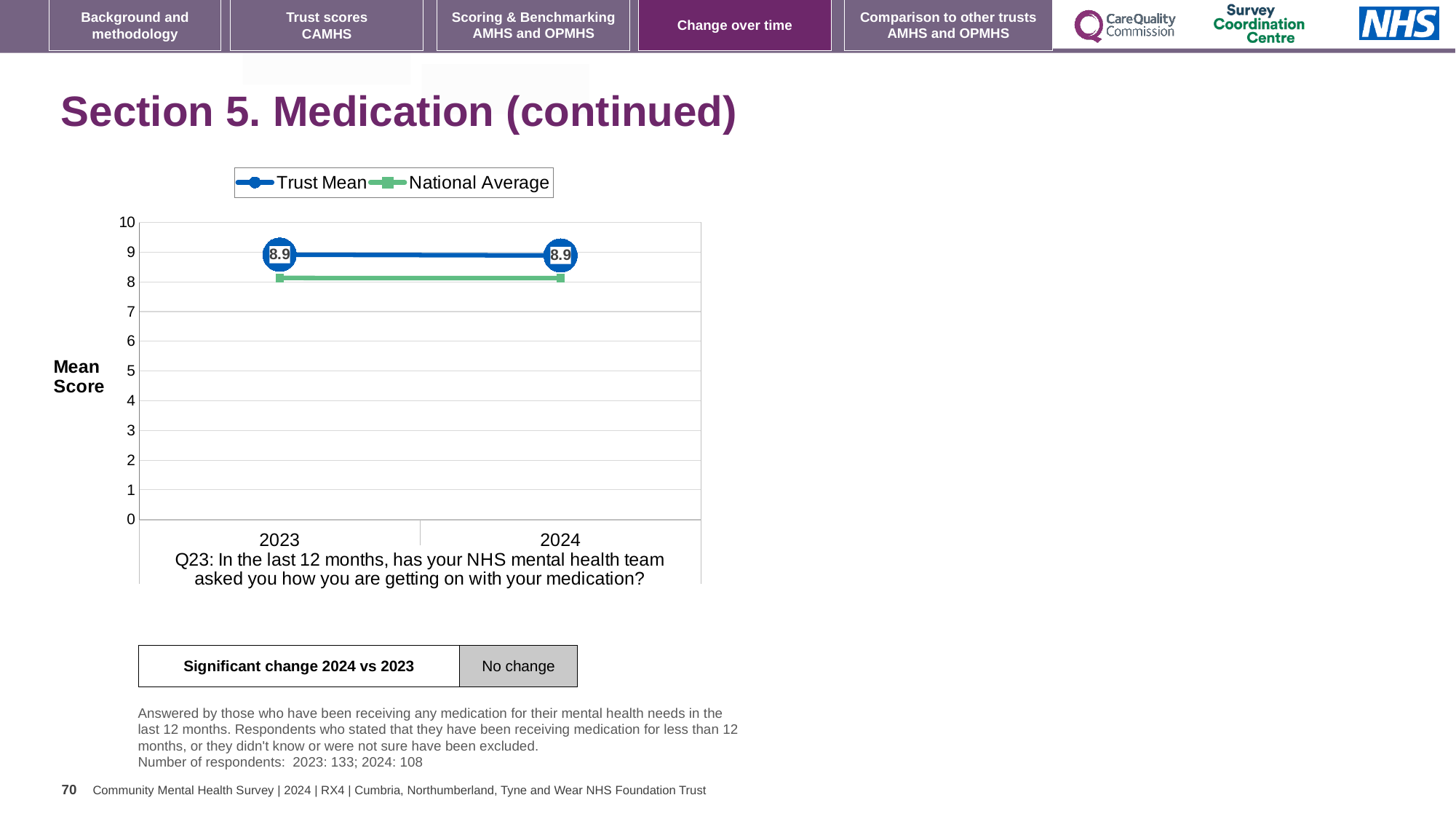
What is the Trust Mean value for 2023? 8.9 Is the National Average value for 2024 greater or less than 7? greater What are the two series named in the legend? Trust Mean and National Average What is the label on the y axis of the chart? Mean Score Is the National Average value for 2023 greater or less than 9? less What is the difference between the Trust Mean in 2024 and the Trust Mean in 2023? 0 What kind of chart is shown on the slide? Line chart How many series does the legend list? 2 In 2024, which is larger: the Trust Mean or the National Average? Trust Mean What is the Trust Mean value for 2024? 8.9 Does the Trust Mean rise, fall or stay the same from 2023 to 2024? Stays the same How many years are plotted on the x axis? 2